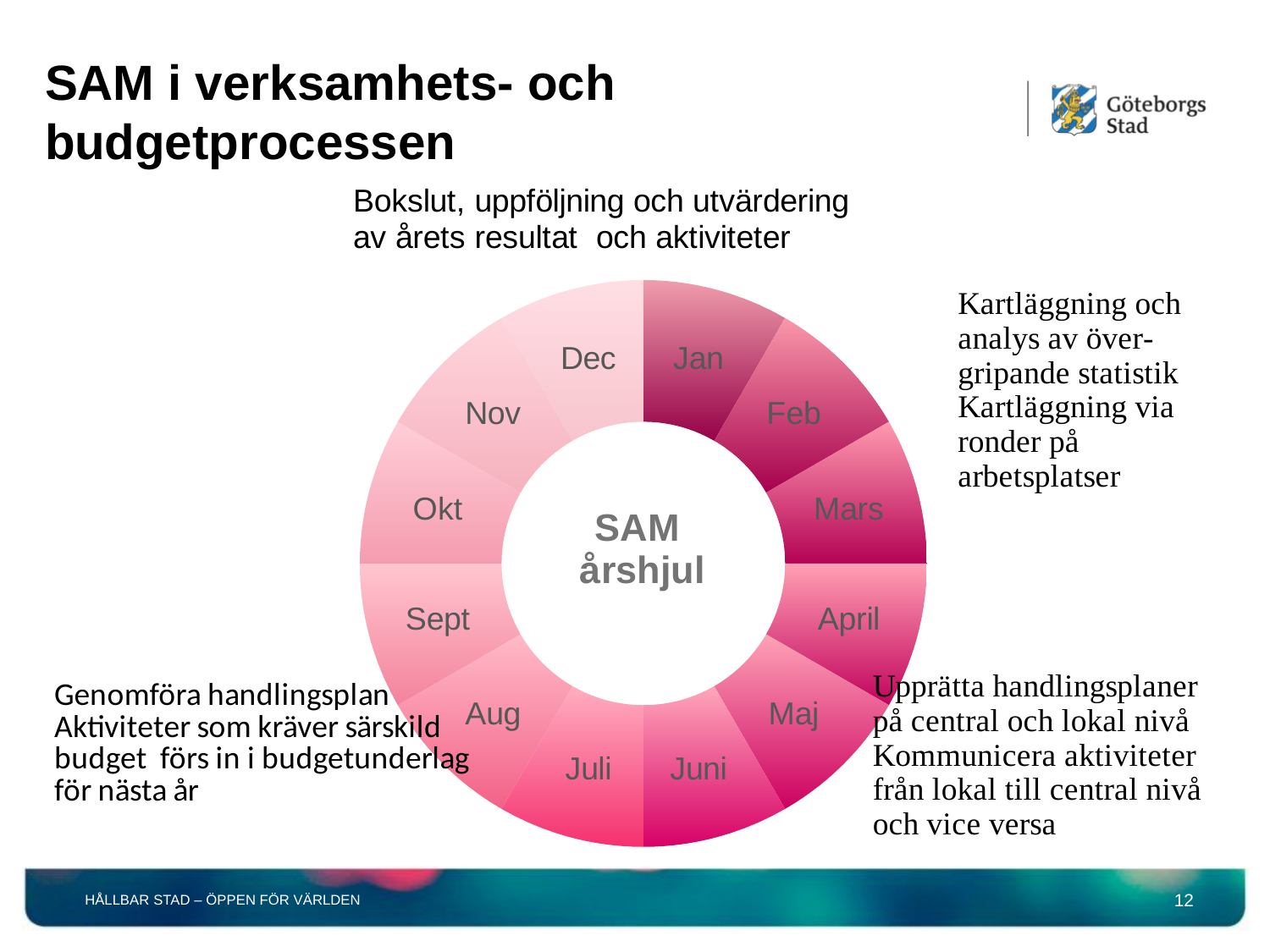
Which segment of the doughnut chart is the lightest in colour? Dec Which segment of the doughnut chart is labelled between Jan and Mars? Feb What kind of chart is shown on the slide? doughnut chart Which segment of the doughnut chart sits directly to the right of Dec at the top? Jan How many segments does the doughnut chart have? 12 What text is written in the centre of the doughnut chart? SAM årshjul Which segment of the doughnut chart is labelled between Maj and Juli? Juni Which segment of the doughnut chart comes immediately after Sept going clockwise? Okt